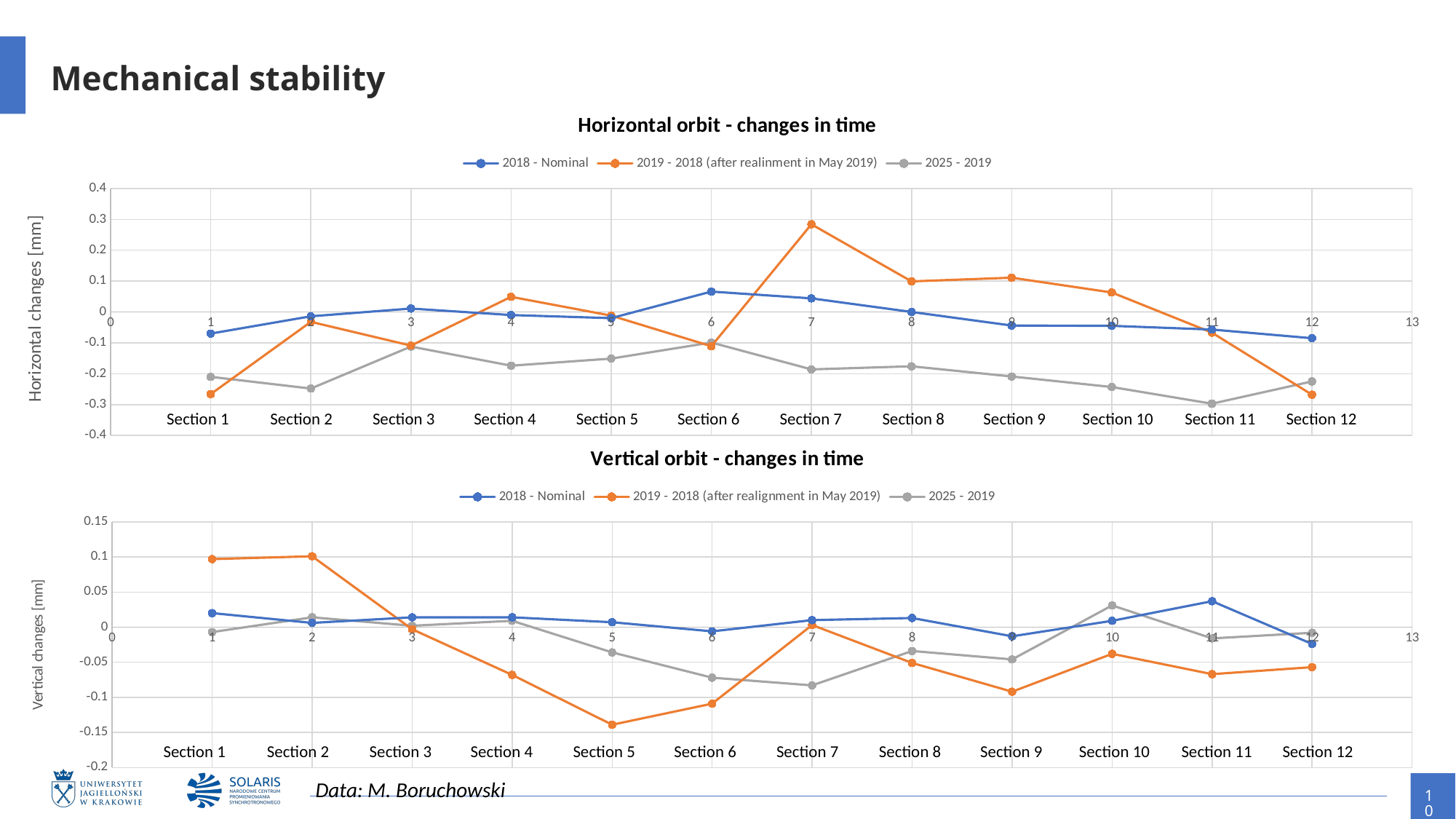
In the 'Vertical orbit - changes in time' chart, at which section does the '2019 - 2018 (after realignment in May 2019)' series reach its lowest value? Section 5 In the 'Vertical orbit - changes in time' chart, is the value of the '2019 - 2018 (after realignment in May 2019)' series at Section 5 greater or less than -0.1? less How many series does the legend of the 'Vertical orbit - changes in time' chart list? 3 What is the y-axis label of the 'Horizontal orbit - changes in time' chart? Horizontal changes [mm] In the 'Vertical orbit - changes in time' chart, at Section 5, which series has the larger value: '2018 - Nominal' or '2019 - 2018 (after realignment in May 2019)'? 2018 - Nominal In the 'Horizontal orbit - changes in time' chart, at which section does the '2019 - 2018 (after realinment in May 2019)' series reach its highest value? Section 7 What kind of chart is the 'Horizontal orbit - changes in time' chart? line chart In the 'Horizontal orbit - changes in time' chart, is the value of the '2019 - 2018 (after realinment in May 2019)' series at Section 7 greater or less than 0.2? greater In the 'Horizontal orbit - changes in time' chart, at Section 7, which series has the larger value: '2018 - Nominal' or '2019 - 2018 (after realinment in May 2019)'? 2019 - 2018 (after realinment in May 2019) In the 'Vertical orbit - changes in time' chart, at which section does the '2025 - 2019' series reach its highest value? Section 10 In the 'Horizontal orbit - changes in time' chart, at which section does the '2025 - 2019' series reach its lowest value? Section 11 How many sections are plotted along the x axis of the 'Horizontal orbit - changes in time' chart? 12